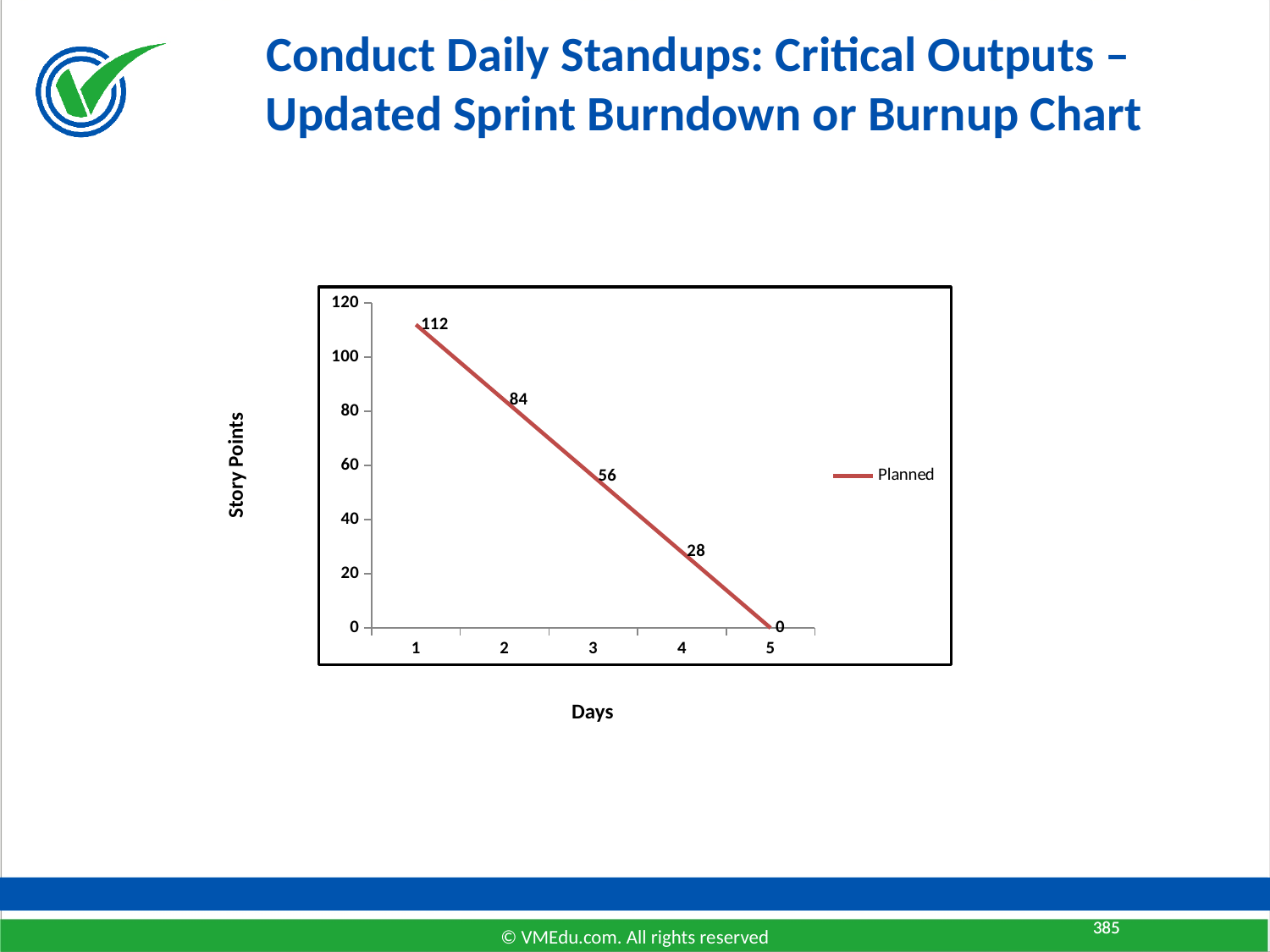
Which is larger, the Planned value on day 2 or on day 3? day 2 On which day is the Planned story points value lowest? 5 What is the Planned story points value on day 1? 112 On which day is the Planned story points value highest? 1 Is the Planned value on day 4 greater or less than 40? less What is the Planned story points value on day 5? 0 What is the difference between the Planned values on day 2 and day 4? 56 How many days are plotted on the x axis? 5 Do the Planned story points rise or fall from day 1 to day 5? fall What kind of chart is shown on the slide? line chart What is the Planned story points value on day 3? 56 How many series does the legend list? 1